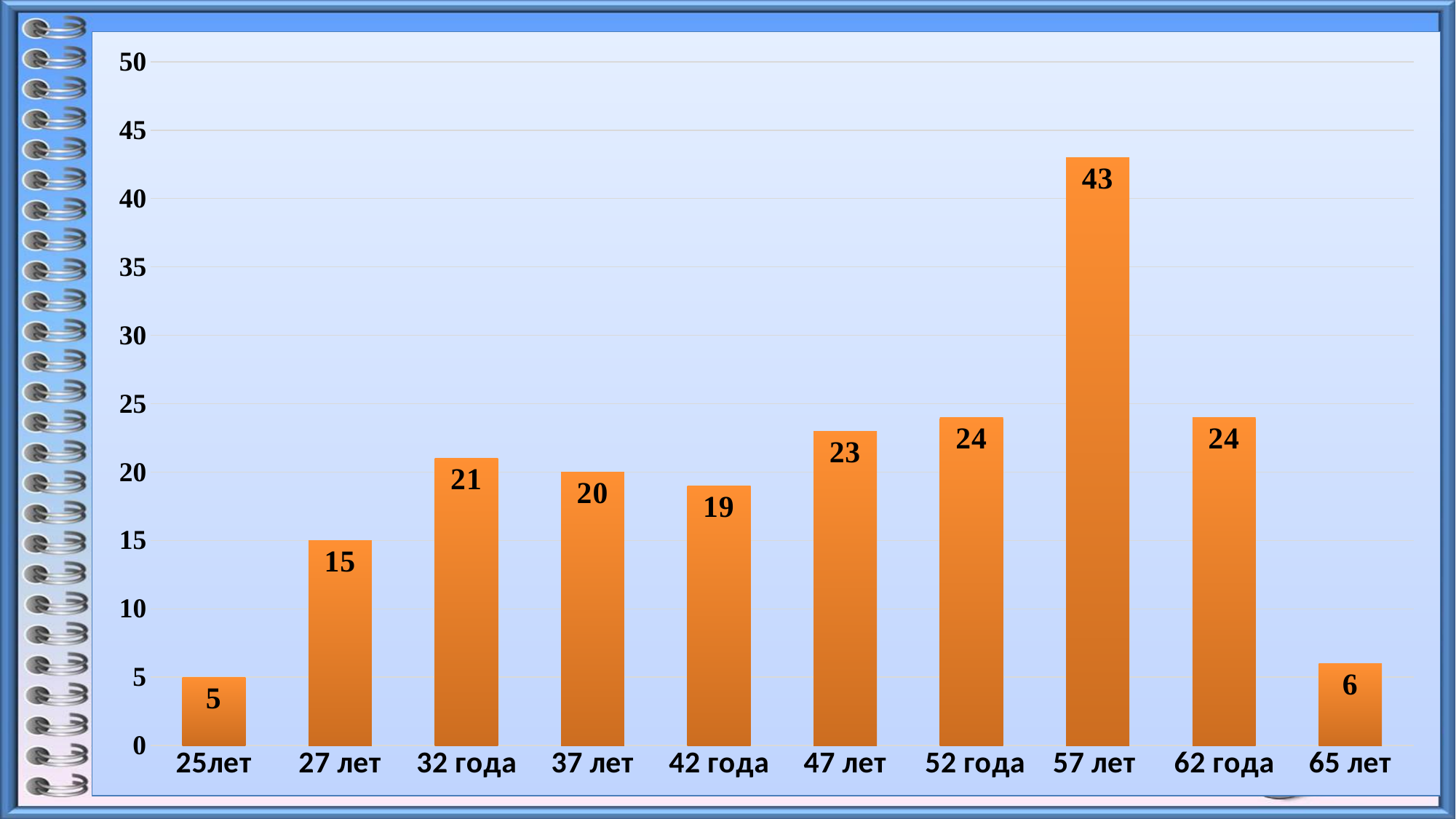
Which is larger, the value for 32 года or the value for 37 лет? 32 года Which is larger, the value for 65 лет or the value for 47 лет? 47 лет What colour are the bars in the chart? orange How many categories are shown on the x axis? 10 What is the value for 57 лет? 43 What kind of chart is shown on the slide? bar chart What is the value for 25лет? 5 What is the difference between the values for 27 лет and 25лет? 10 What is the difference between the values for 57 лет and 62 года? 19 What is the value for 42 года? 19 Which category has the highest value? 57 лет Which category has the lowest value? 25лет